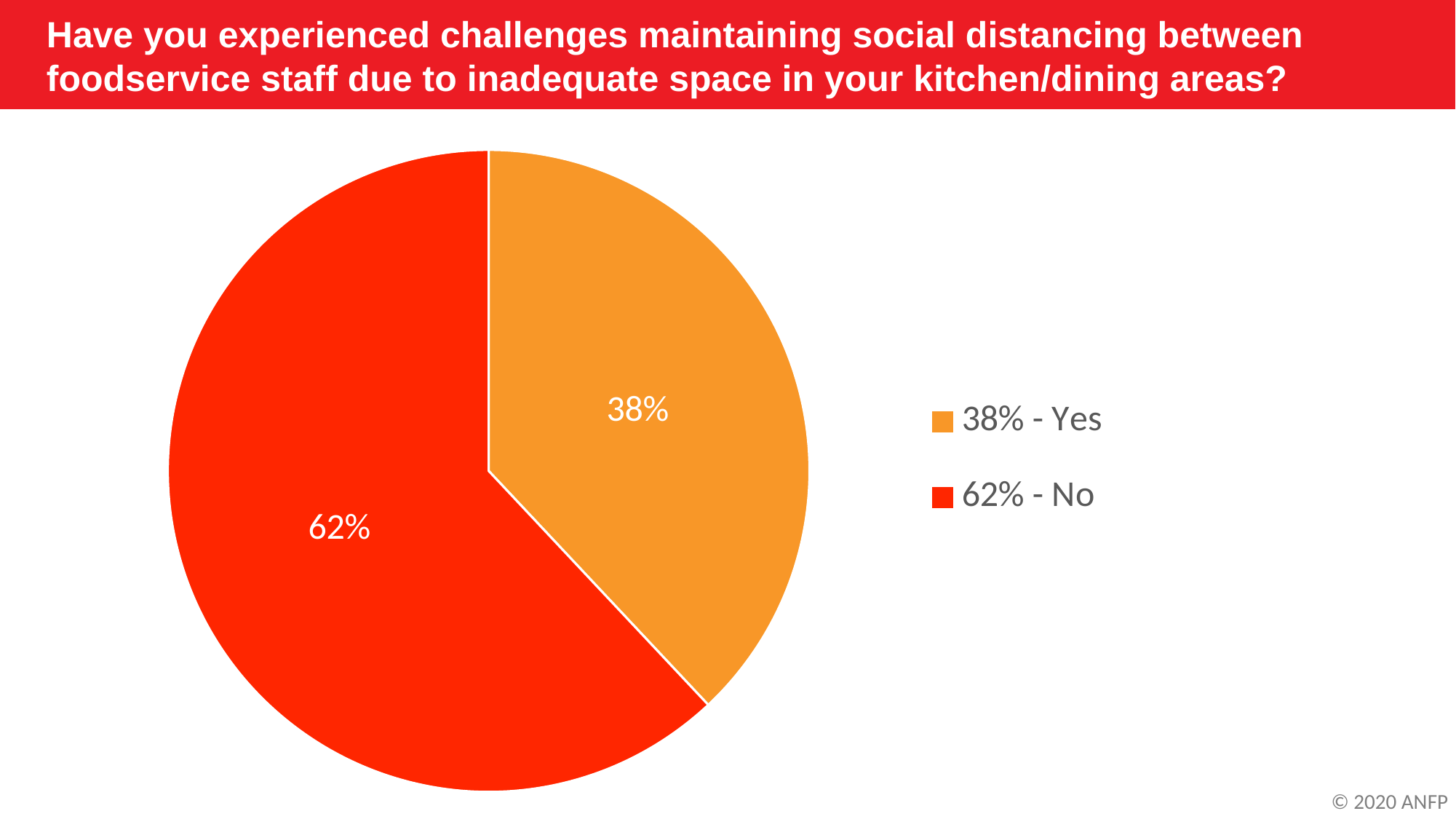
Which response has the largest share of the pie? No How many slices does the pie chart have? 2 What is the difference in percentage points between the No and Yes responses? 24 Which is larger, the share for Yes or the share for No? No What colour is the slice representing Yes? orange What percentage of respondents answered Yes? 38% What percentage of respondents answered No? 62% Which response has the smallest share of the pie? Yes What colour is the slice representing No? red How many entries does the legend list? 2 What share of the pie does the Yes slice represent? 38% What kind of chart is shown on the slide? pie chart